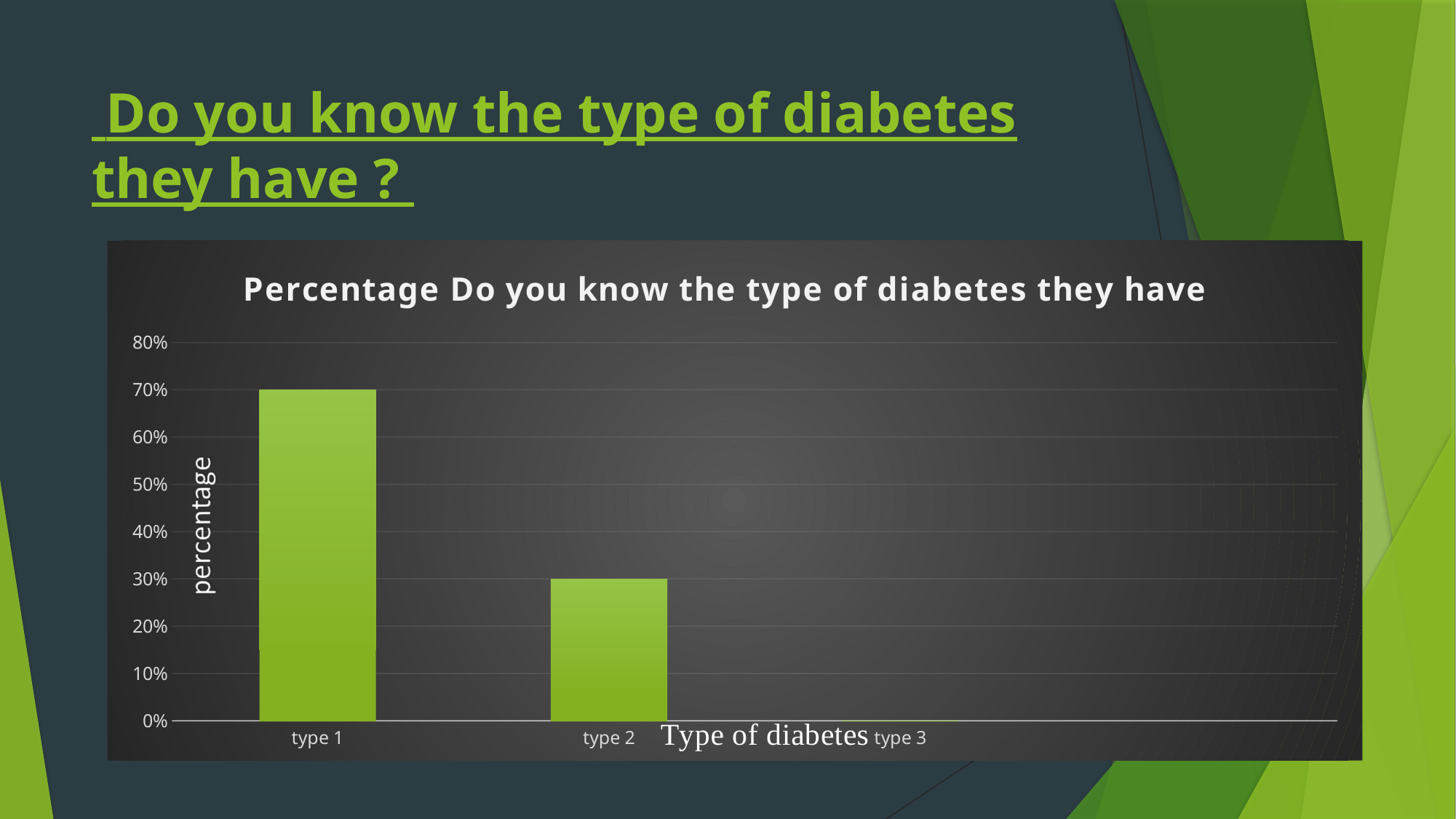
How many categories are shown on the x axis of the chart? 3 Which type of diabetes has the lowest percentage? type 3 What is the percentage for type 1? 70% What type of chart is shown on the slide? bar chart What is the label of the y axis? percentage Is the value for type 3 greater or less than 10%? less What is the percentage for type 2? 30% What is the title of the chart? Percentage Do you know the type of diabetes they have Which type of diabetes has the highest percentage? type 1 Which is larger, the percentage for type 1 or type 2? type 1 Is the value for type 1 greater or less than 60%? greater What is the difference between the percentages for type 1 and type 2? 40%